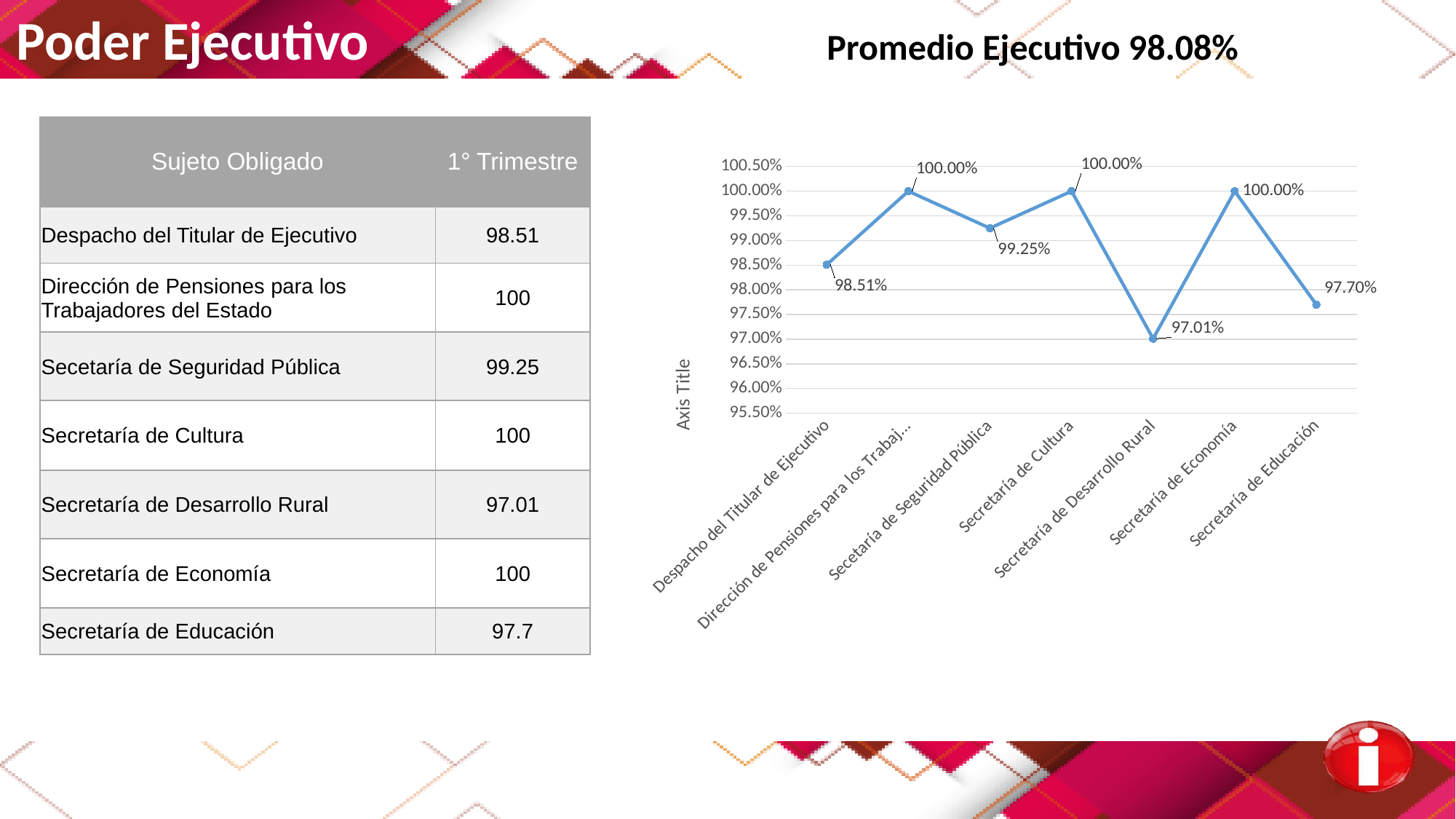
What is the value for Secretaría de Desarrollo Rural in the chart? 97.01% What is the value for Secretaría de Educación in the chart? 97.70% What is the value for Secretaría de Seguridad Pública in the chart? 99.25% What is the value for Despacho del Titular de Ejecutivo in the chart? 98.51% Is the value for Secretaría de Educación greater or less than 98.00%? less What is the label on the vertical axis of the chart? Axis Title What kind of chart is shown on the slide? line chart How many categories are plotted on the x axis of the chart? 7 Which is larger in the chart, the value for Secretaría de Seguridad Pública or the value for Secretaría de Educación? Secretaría de Seguridad Pública What is the difference between the value for Despacho del Titular de Ejecutivo and the value for Secretaría de Desarrollo Rural? 1.50% Which category has the lowest value in the chart? Secretaría de Desarrollo Rural Does the line rise or fall from Secretaría de Cultura to Secretaría de Desarrollo Rural? fall